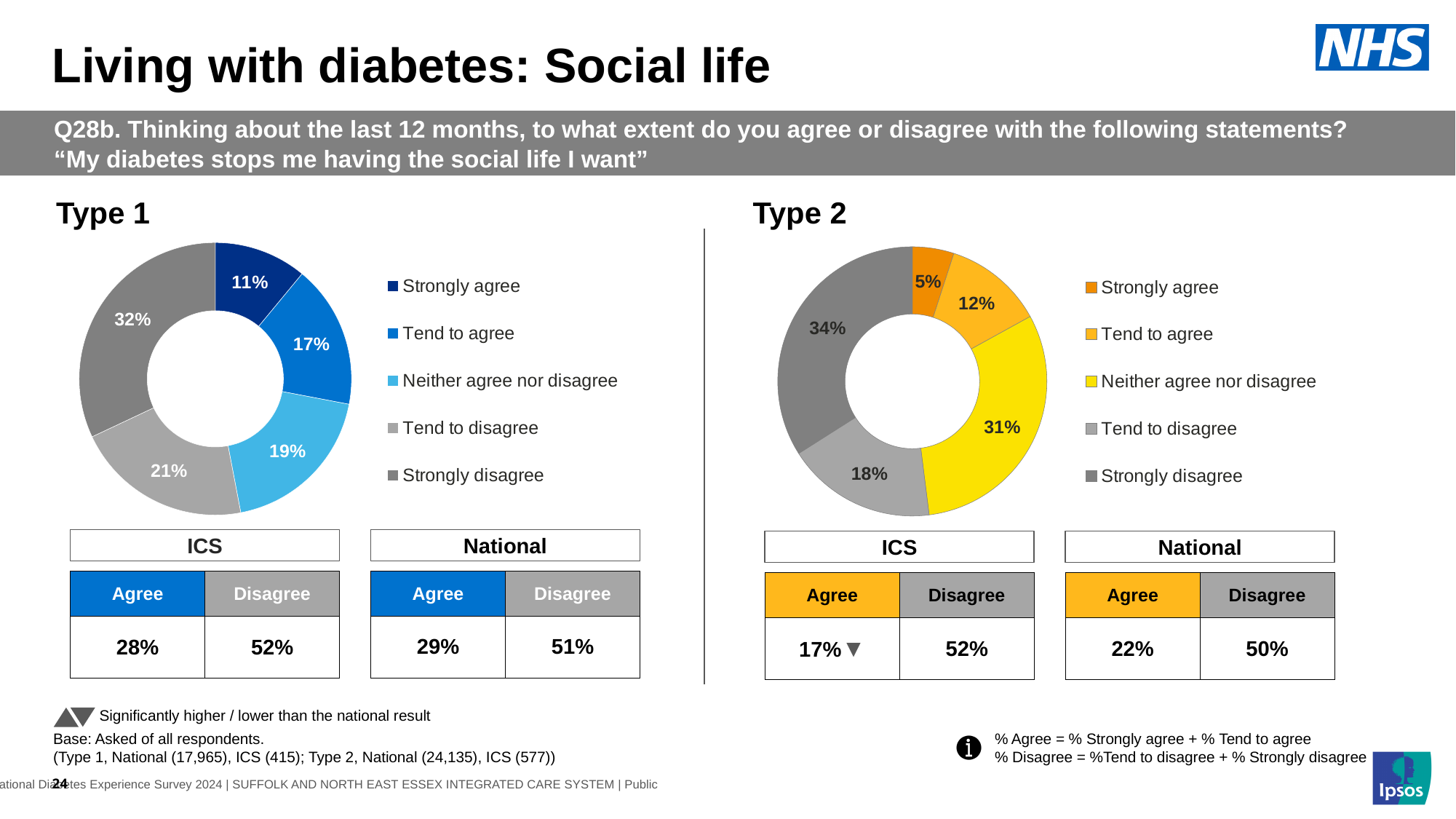
In the Type 2 chart, which response category has the smallest share? Strongly agree In the Type 2 chart, what is the difference between the 'Tend to agree' share and the 'Strongly agree' share? 7 percentage points In the Type 2 chart, what colour is the 'Neither agree nor disagree' segment? Yellow In the Type 1 chart, what is the difference between the 'Strongly disagree' share and the 'Tend to disagree' share? 11 percentage points In the Type 1 chart, what percentage of respondents said 'Strongly agree'? 11% Which chart has the larger 'Strongly agree' share, Type 1 or Type 2? Type 1 In the Type 1 chart, what is the combined share of 'Strongly agree' and 'Tend to agree'? 28% What kind of chart is used to show the Type 2 results? Donut (pie) chart In the Type 2 chart, what percentage of respondents said 'Neither agree nor disagree'? 31% In the Type 2 chart, which is larger: the 'Neither agree nor disagree' share or the 'Tend to disagree' share? Neither agree nor disagree In the Type 1 chart, which response category has the largest share? Strongly disagree How many response categories does the Type 1 chart's legend list? 5